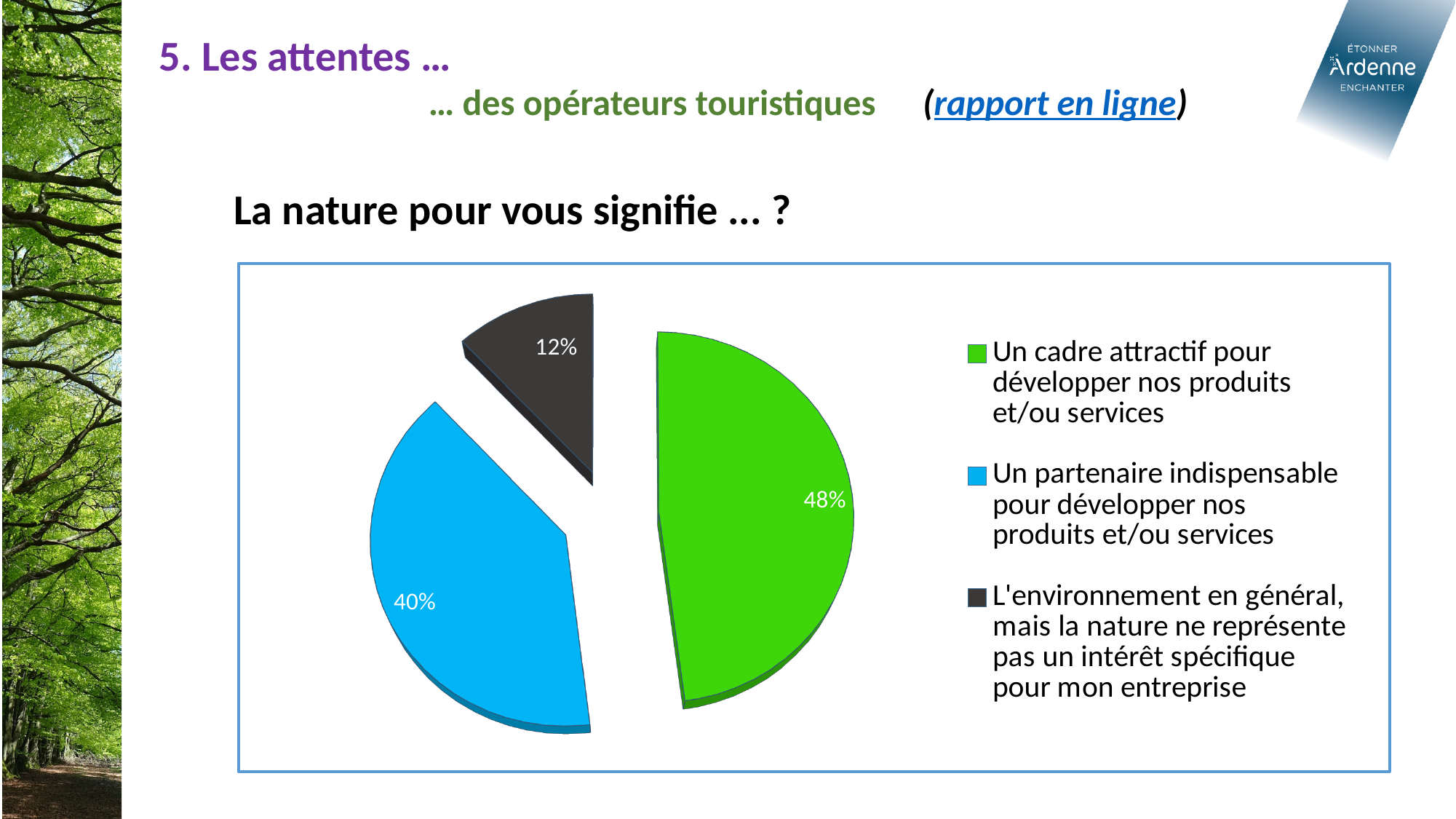
What question does the chart answer, according to the heading above it? La nature pour vous signifie ... ? What share of the pie is 'L'environnement en général, mais la nature ne représente pas un intérêt spécifique pour mon entreprise'? 12% What colour is the slice for 'Un partenaire indispensable pour développer nos produits et/ou services'? Blue What is the difference in percentage points between the 'Un partenaire indispensable' slice and the 'L'environnement en général' slice? 28 Which category has the largest slice of the pie? Un cadre attractif pour développer nos produits et/ou services What kind of chart is shown on the slide? Pie chart What is the difference in percentage points between the 'Un cadre attractif' slice and the 'Un partenaire indispensable' slice? 8 What share of the pie is 'Un partenaire indispensable pour développer nos produits et/ou services'? 40% Which is larger: the 'Un partenaire indispensable' slice or the 'L'environnement en général' slice? Un partenaire indispensable pour développer nos produits et/ou services How many slices does the pie chart have? 3 What share of the pie is 'Un cadre attractif pour développer nos produits et/ou services'? 48% Which category has the smallest slice of the pie? L'environnement en général, mais la nature ne représente pas un intérêt spécifique pour mon entreprise